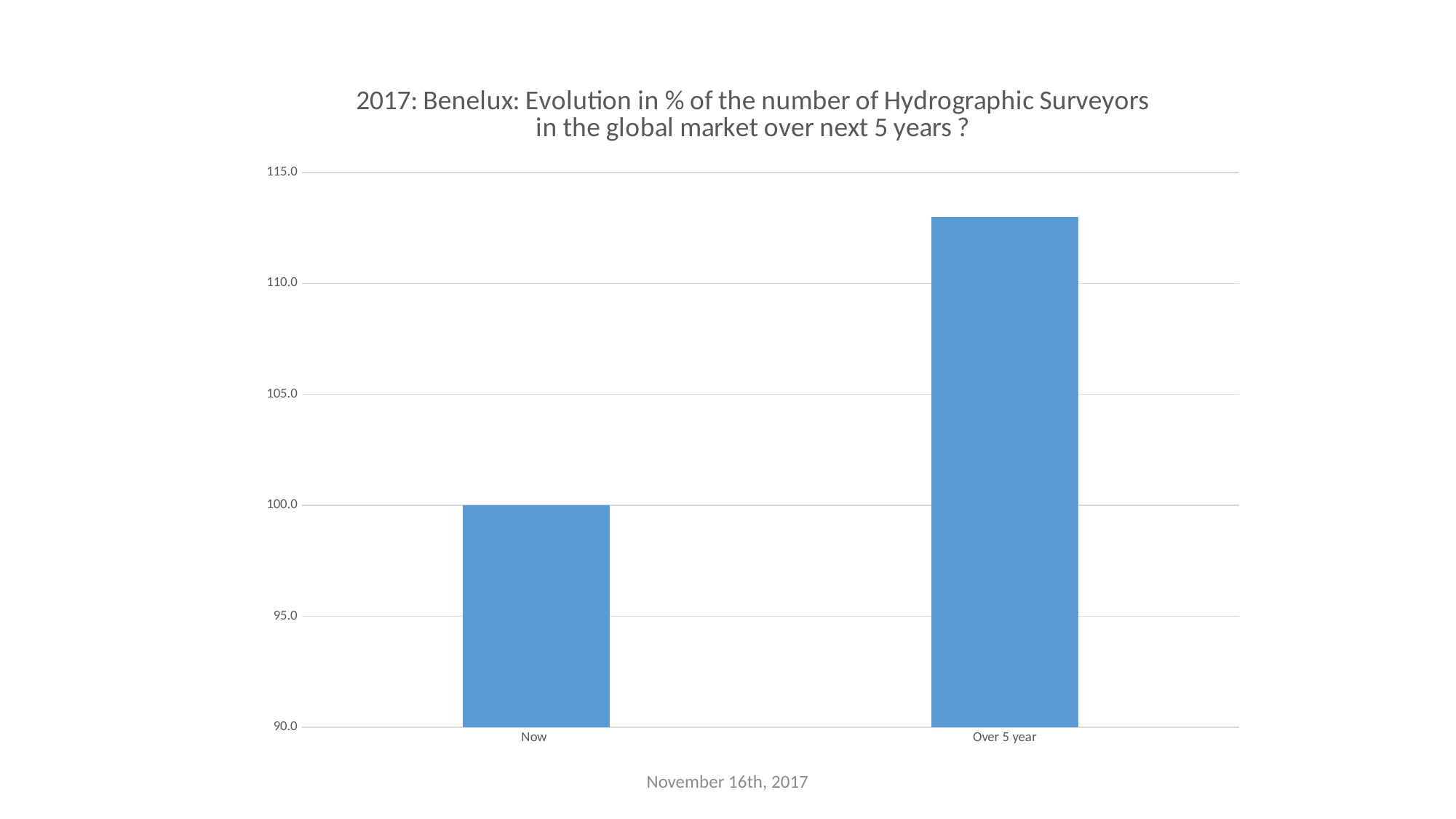
Do the values rise or fall from Now to Over 5 year? Rise Is the value for Over 5 year greater or less than 115.0? less What colour are the bars in the chart? Blue What is the lowest value shown on the y axis? 90.0 Which is larger, the value for Now or the value for Over 5 year? Over 5 year How many categories are shown on the x axis? 2 Which category has the lowest value? Now What is the value for Now? 100.0 Which category has the highest value? Over 5 year What kind of chart is shown on the slide? Bar chart Is the value for Over 5 year greater or less than 110.0? greater